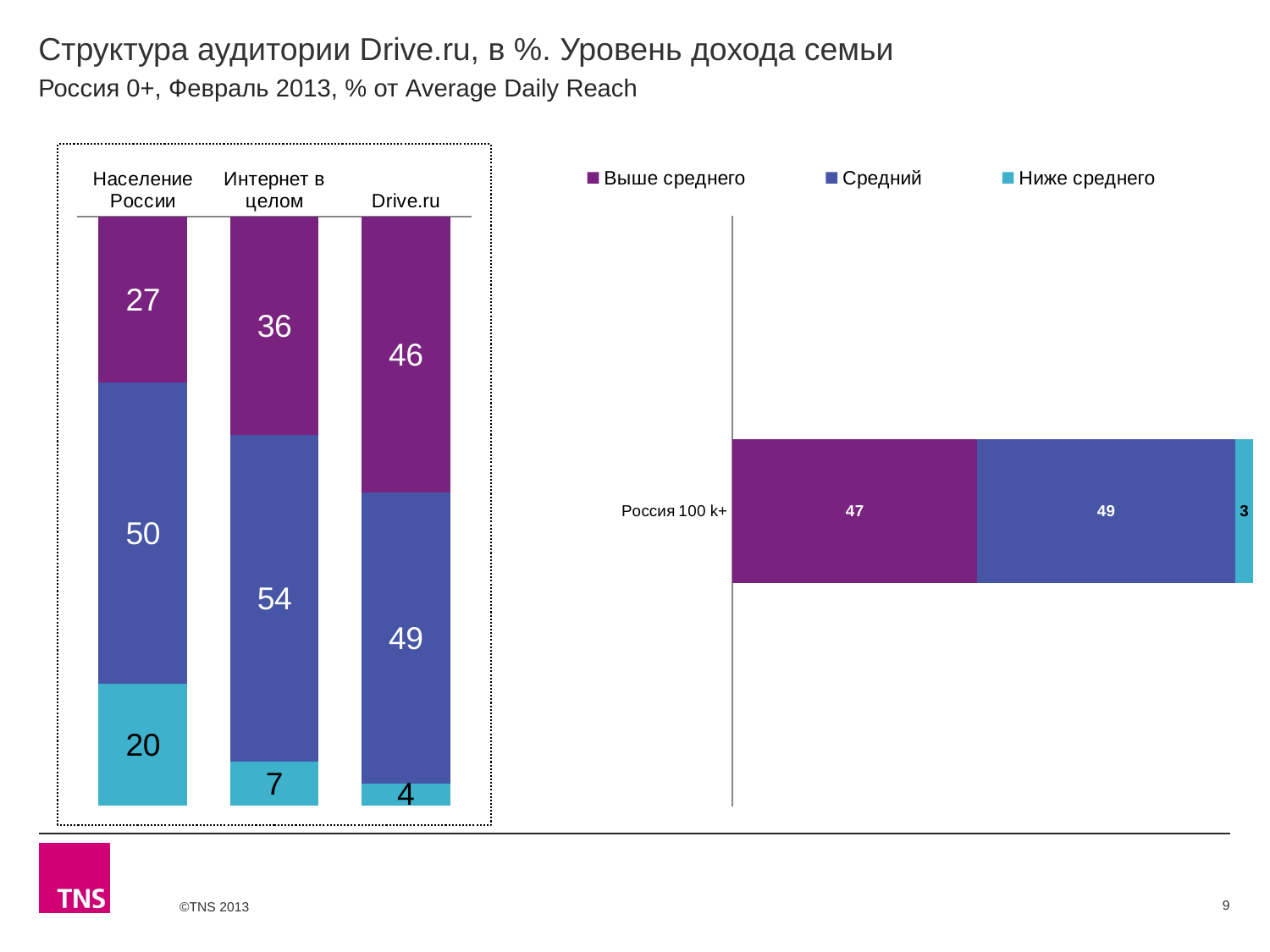
How many categories are shown in the left chart? 3 In the left chart, what is the difference between the 'Выше среднего' values for Drive.ru and Население России? 19 In the left chart, what is the value of the 'Средний' segment for Интернет в целом? 54 In the right chart, what is the value of the 'Средний' segment for Россия 100 k+? 49 What type of chart is the right chart? Stacked bar chart In the left chart, what is the value of the 'Ниже среднего' segment for Население России? 20 How many series does the legend list? 3 In the left chart, which is larger: the 'Средний' value for Интернет в целом or for Drive.ru? Интернет в целом In the left chart, which category has the lowest 'Ниже среднего' value? Drive.ru In the right chart, what is the total of the stacked bar for Россия 100 k+? 99 In the left chart, what is the value of the 'Выше среднего' segment for Drive.ru? 46 In the left chart, which category has the highest 'Выше среднего' value? Drive.ru